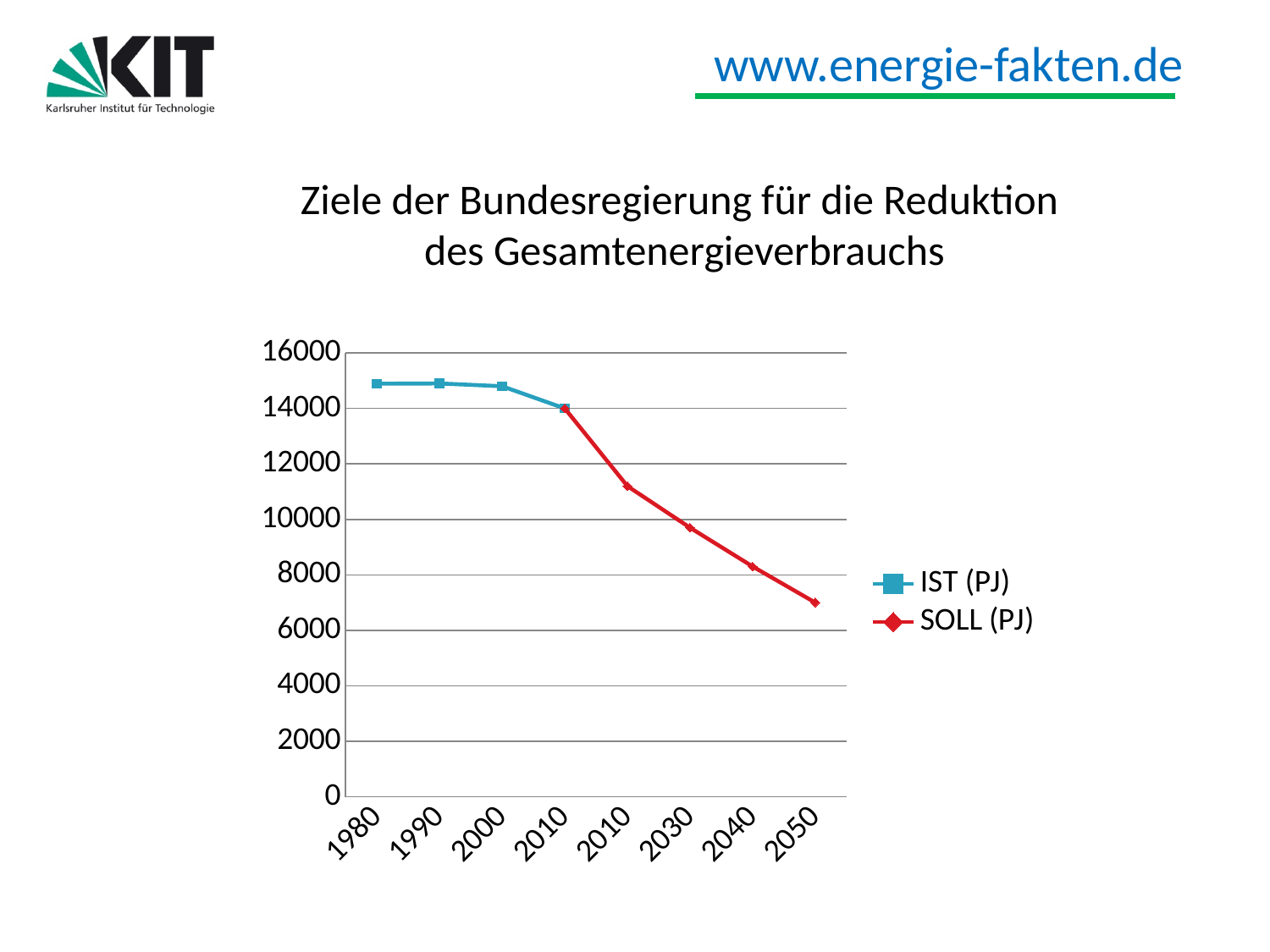
In which year does the SOLL (PJ) series reach its lowest value? 2050 What is the title of the chart? Ziele der Bundesregierung für die Reduktion des Gesamtenergieverbrauchs Which colour is used for the SOLL (PJ) series? red Do the SOLL (PJ) values rise or fall from 2010 to 2050? fall Is the SOLL (PJ) value for 2050 greater or less than 8000? less What kind of chart is shown on the slide? line chart How many categories are shown on the x axis? 8 Is the IST (PJ) value for 1980 greater or less than 14000? greater Which is larger: the IST (PJ) value for 1980 or the SOLL (PJ) value for 2050? IST (PJ) value for 1980 How many series does the legend list? 2 Is the SOLL (PJ) value for 2040 greater or less than 10000? less